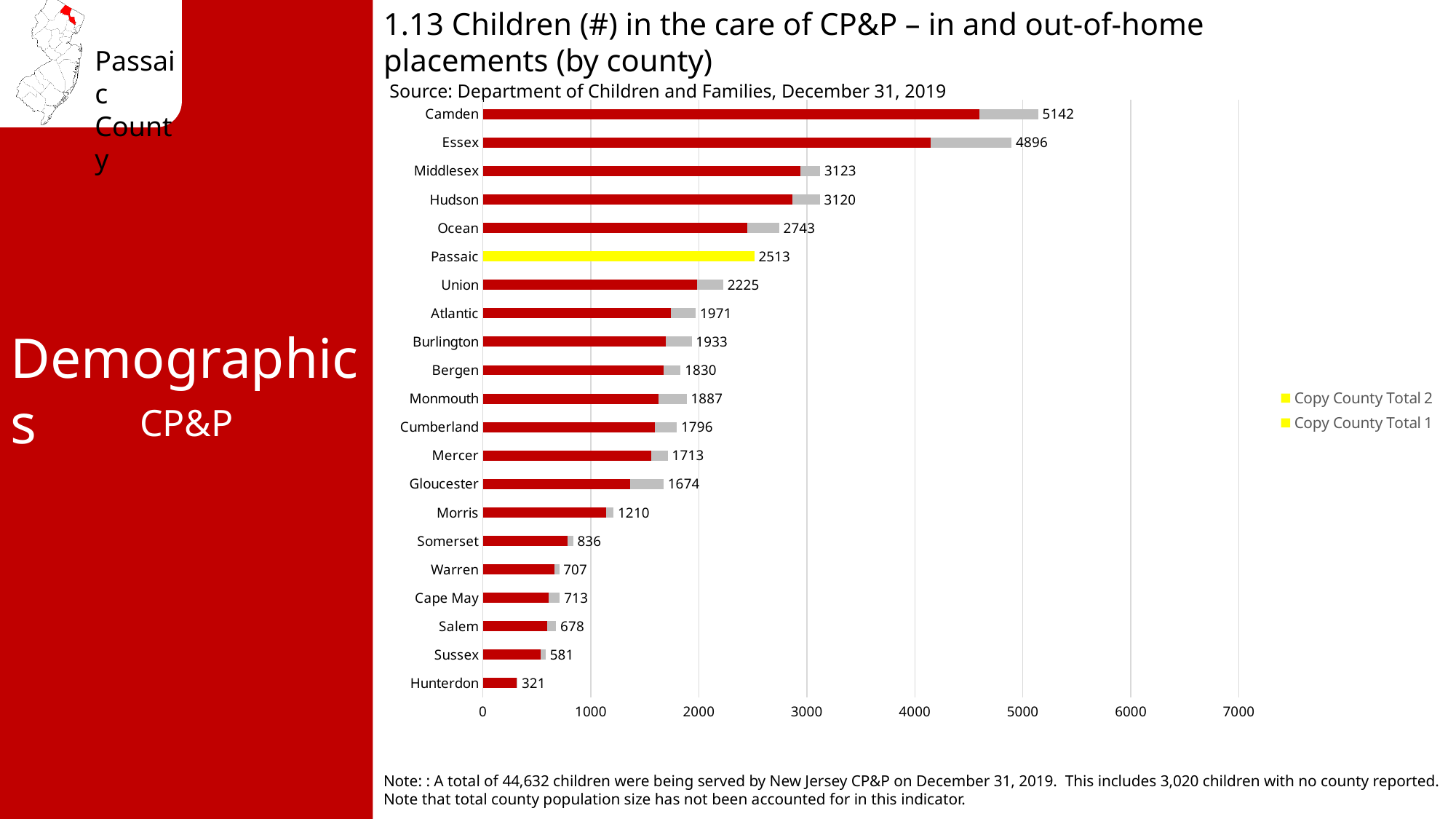
How many series does the legend list? 2 Which county has the highest number of children in the care of CP&P? Camden Is the value for Ocean County greater or less than 2000? greater What is the difference between the values for Camden and Essex? 246 What is the value shown for Camden County? 5142 What is the value shown for Hunterdon County? 321 What kind of chart is shown on the slide? Bar chart Which has a larger value, Monmouth or Bergen? Monmouth Which county has the lowest number of children in the care of CP&P? Hunterdon How many counties are shown in the chart? 21 What is the difference between the values for Passaic and Union? 288 What is the total number of children in the care of CP&P for Passaic County? 2513